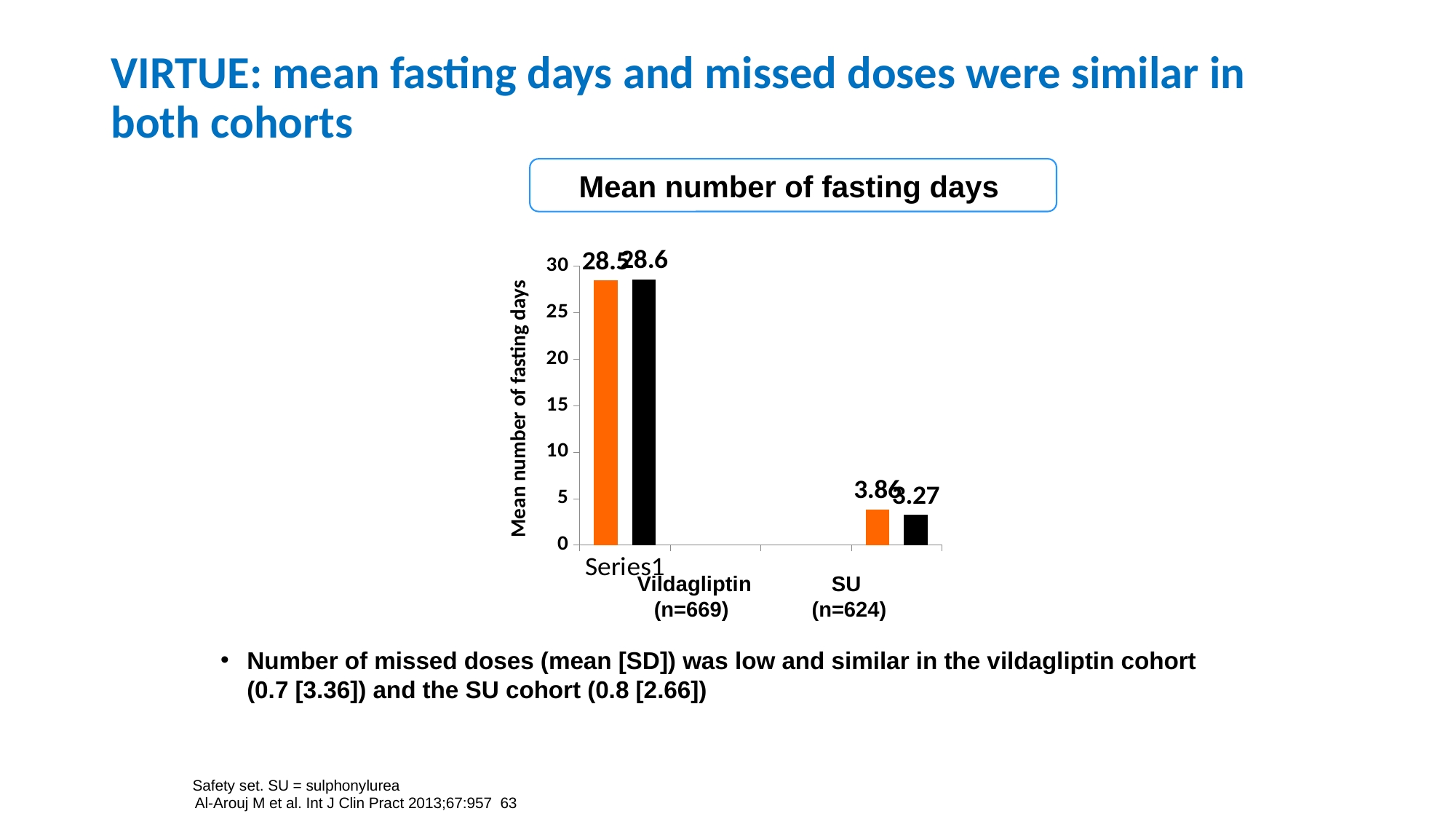
What is the value of the orange bar for the SU (n=624) group? 3.86 What is the title of the chart? Mean number of fasting days What is the difference between the orange and black bars for the SU group? 0.59 What is the value of the black bar for the SU (n=624) group? 3.27 Which group has the lowest mean number of fasting days? SU (n=624) How many treatment groups are shown on the x axis of the chart? 2 What is the value of the black bar for the Vildagliptin (n=669) group? 28.6 What kind of chart is shown on the slide? bar chart Is the value of the orange bar for the SU group greater or less than 5? less Is the value of the black bar for the Vildagliptin group greater or less than 25? greater Which group has the higher mean number of fasting days, Vildagliptin or SU? Vildagliptin What is the label on the y axis of the chart? Mean number of fasting days